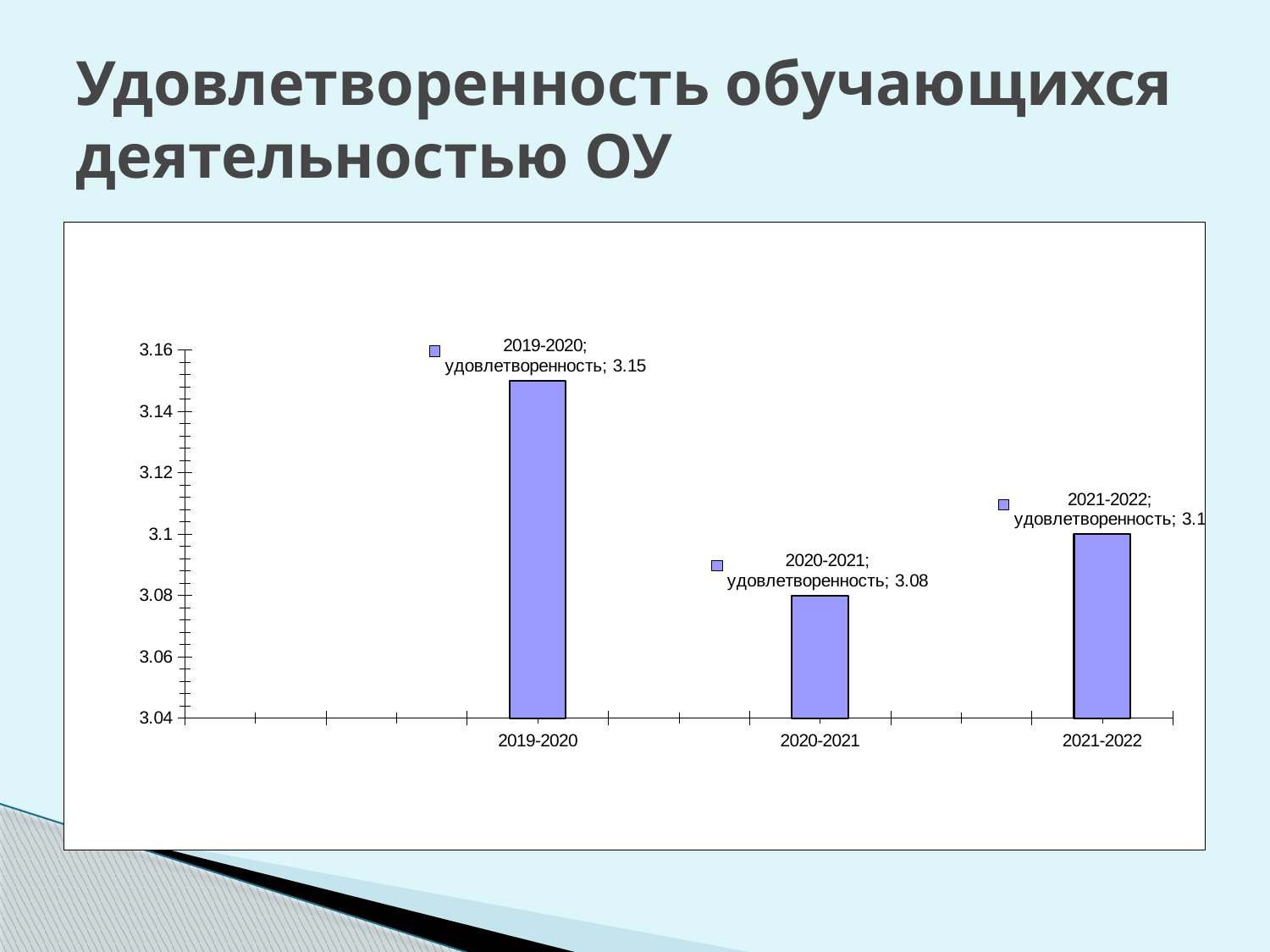
What is the difference between the satisfaction values for 2021-2022 and 2020-2021? 0.02 Which year has the highest satisfaction value? 2019-2020 How many years are shown on the x axis? 3 Is the value for 2019-2020 greater or less than 3.12? greater Which is larger, the value for 2021-2022 or the value for 2020-2021? 2021-2022 What is the difference between the satisfaction values for 2019-2020 and 2020-2021? 0.07 What is the satisfaction value for 2019-2020? 3.15 What kind of chart is shown on the slide? bar chart What is the title of the slide? Удовлетворенность обучающихся деятельностью ОУ What is the satisfaction value for 2021-2022? 3.1 What is the satisfaction value for 2020-2021? 3.08 Which year has the lowest satisfaction value? 2020-2021